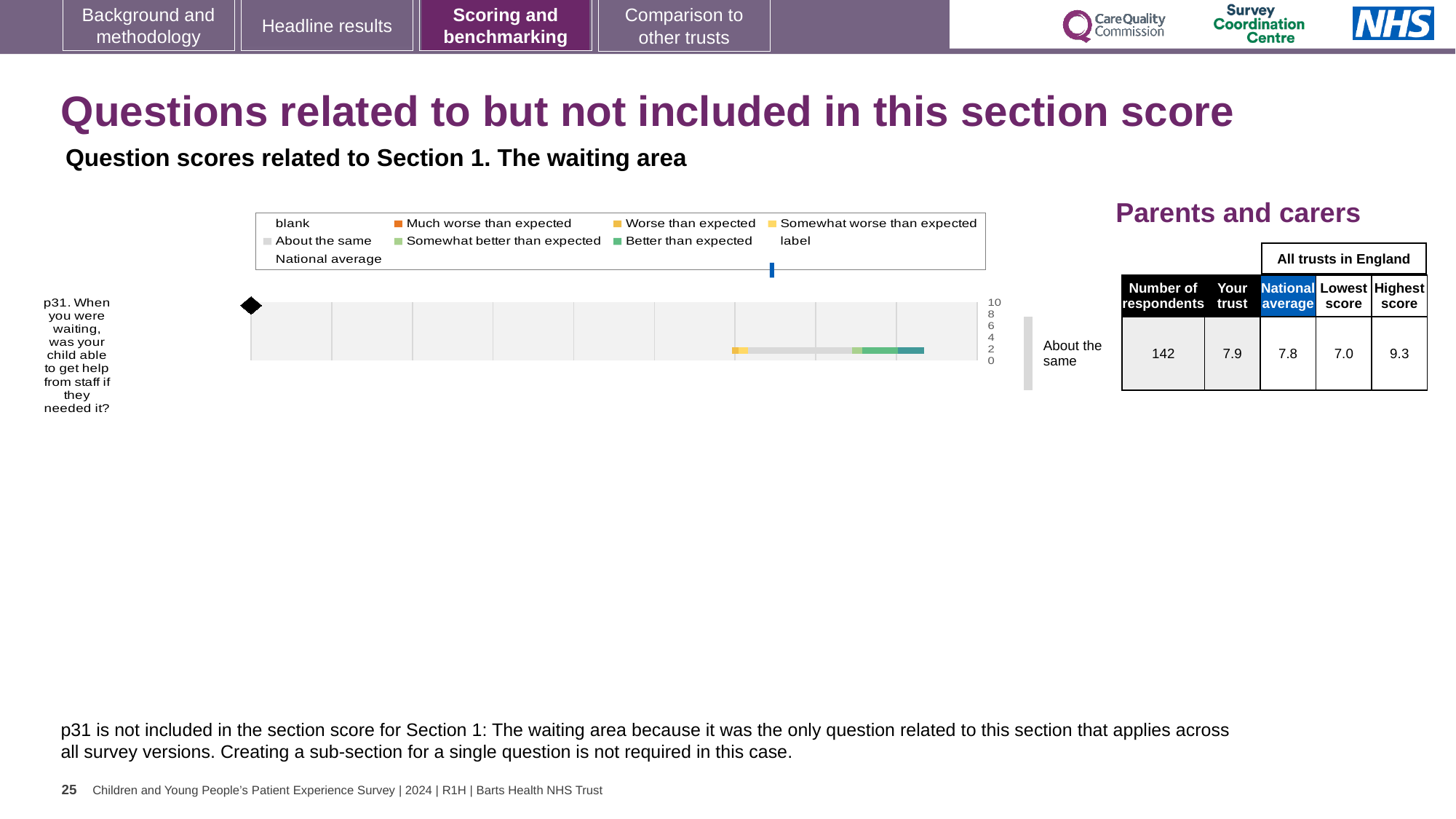
What colour represents 'Much worse than expected' in the chart legend? orange What benchmark category is shown for p31 to the right of the chart? About the same In the Parents and carers table, what is the 'Your trust' score for p31? 7.9 How many respondents answered p31 according to the Parents and carers table? 142 For p31, which is larger: the 'Your trust' score or the National average? Your trust In the Parents and carers table, what is the Lowest score among all trusts in England for p31? 7.0 How many survey questions are plotted in the chart? 1 Which survey question is plotted in the chart? p31. When you were waiting, was your child able to get help from staff if they needed it? In the Parents and carers table, what is the National average score for p31? 7.8 What kind of chart is shown for question p31? bar chart For p31, what is the difference between the Highest score and the Lowest score among all trusts in England? 2.3 In the Parents and carers table, what is the Highest score among all trusts in England for p31? 9.3